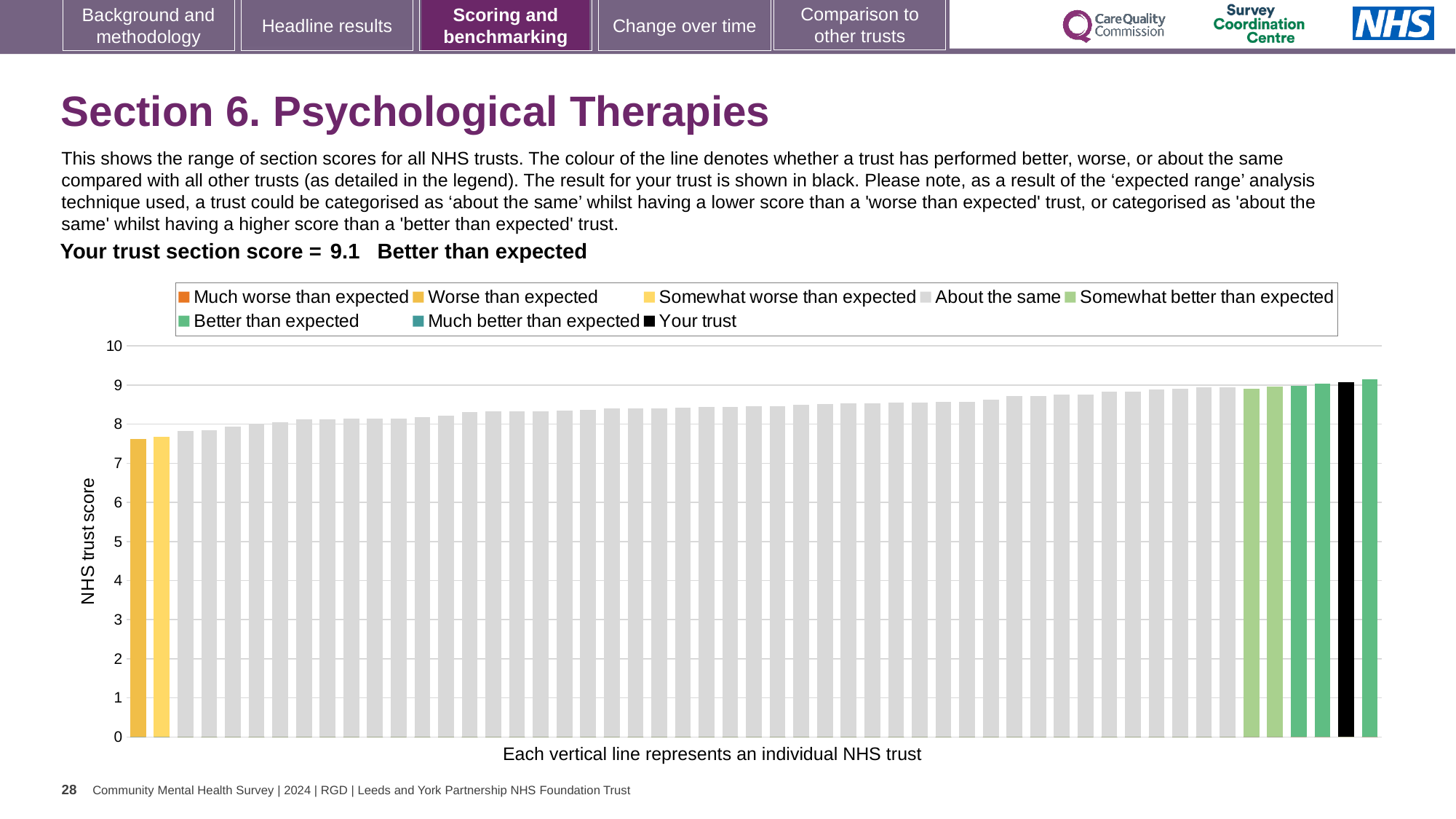
How is your trust's section score categorised on the slide? Better than expected What kind of chart is shown on the slide? bar chart Is the value of the black bar for your trust greater or less than 9? greater What colour is used for the bar representing your trust? black What is the section score for your trust shown on the slide? 9.1 Is the value of the leftmost (lowest) bar greater or less than 7? greater Is the value of the leftmost (lowest) bar greater or less than 8? less How many entries does the chart legend list? 8 Do the bar values rise or fall from left to right across the chart? rise What is the label on the vertical axis of the chart? NHS trust score How many bars are coloured as 'Somewhat better than expected' (light green)? 2 Which legend category does the lowest bar on the chart belong to? Worse than expected